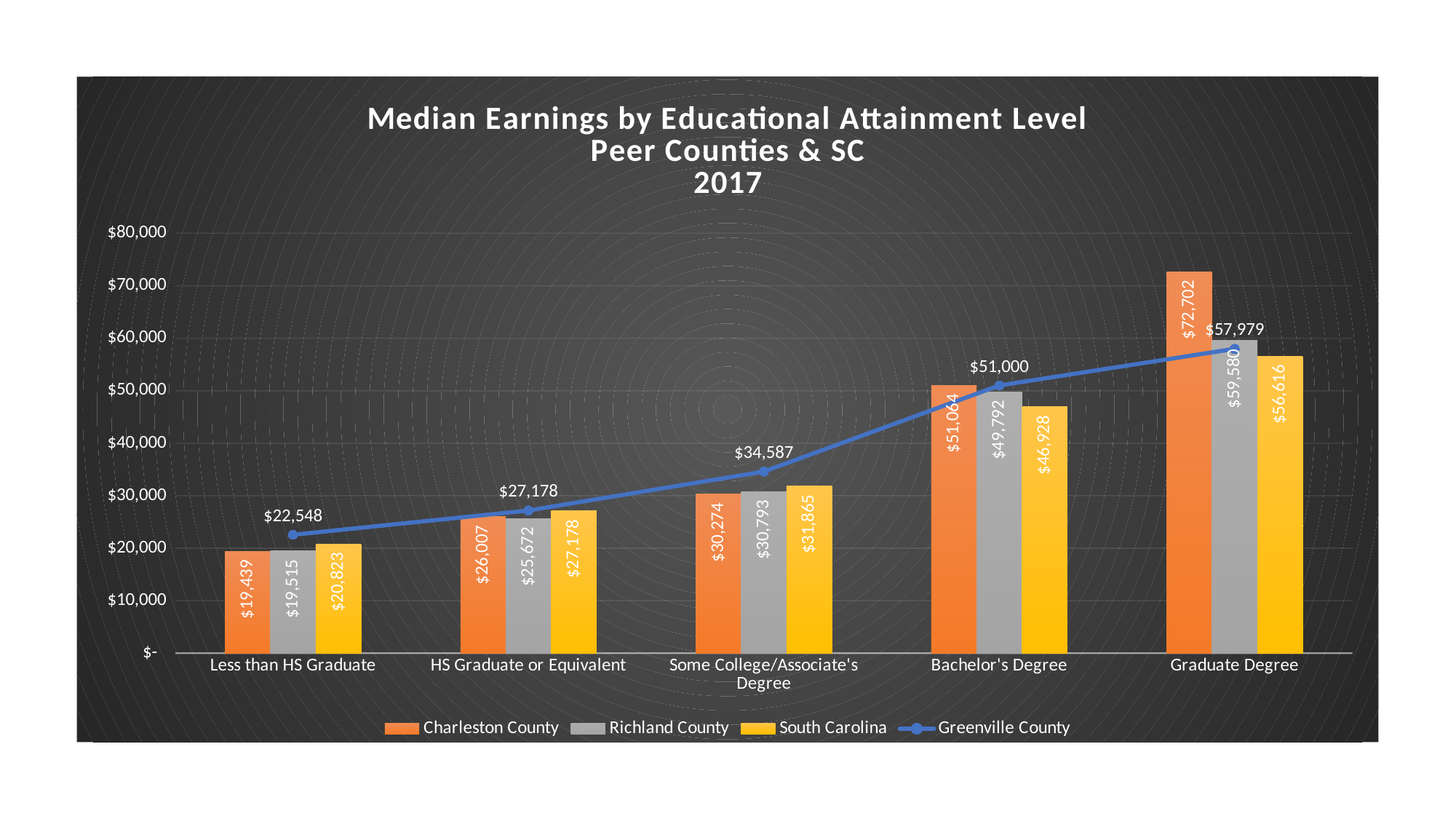
How many series does the legend list? 4 Which educational attainment level has the lowest median earnings for South Carolina? Less than HS Graduate What is the difference between Charleston County and Richland County median earnings at the Graduate Degree level? $13,122 Which series is plotted as a line rather than bars? Greenville County What is the median earnings for Charleston County at the Graduate Degree level? $72,702 Do the Greenville County median earnings rise or fall as educational attainment increases along the x axis? Rise How many educational attainment levels are shown on the x axis? 5 What is the median earnings for Greenville County at the Some College/Associate's Degree level? $34,587 Which educational attainment level has the highest median earnings for Charleston County? Graduate Degree At the Bachelor's Degree level, which is larger: Charleston County or Richland County median earnings? Charleston County What is the median earnings for South Carolina at the Bachelor's Degree level? $46,928 What is the median earnings for Richland County at the Less than HS Graduate level? $19,515